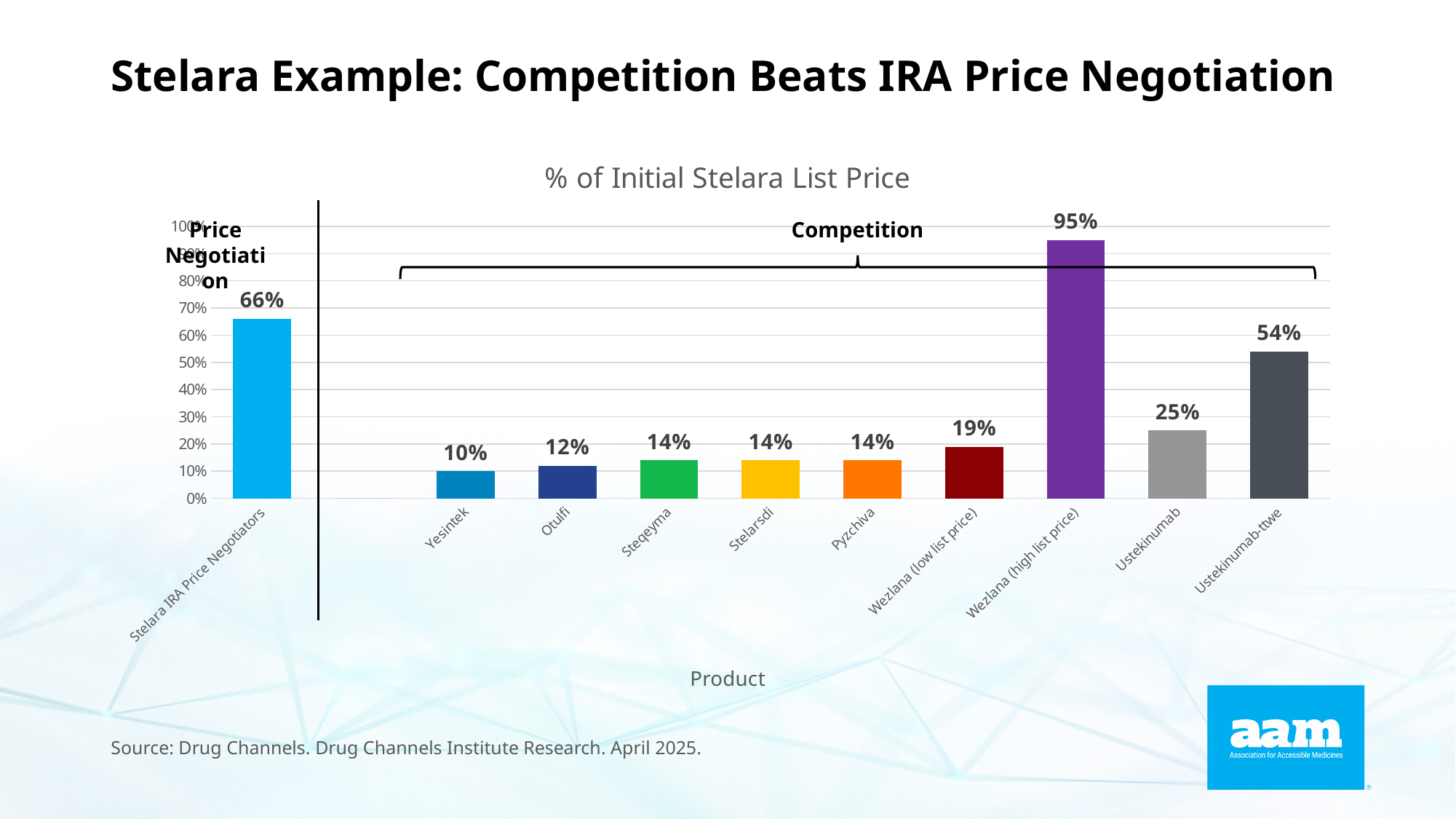
What is the difference between the values for Stelara IRA Price Negotiators and Ustekinumab-ttwe? 12% What is the value for Yesintek? 10% Which product has the highest value? Wezlana (high list price) How many products are shown on the chart? 10 What is the value for Ustekinumab-ttwe? 54% What kind of chart is shown on the slide? Bar chart What is the label of the x axis? Product What is the title of the chart? % of Initial Stelara List Price What is the value for Wezlana (high list price)? 95% What is the value for Stelara IRA Price Negotiators? 66% Which product has the lowest value? Yesintek Which is larger, the value for Ustekinumab or the value for Wezlana (low list price)? Ustekinumab